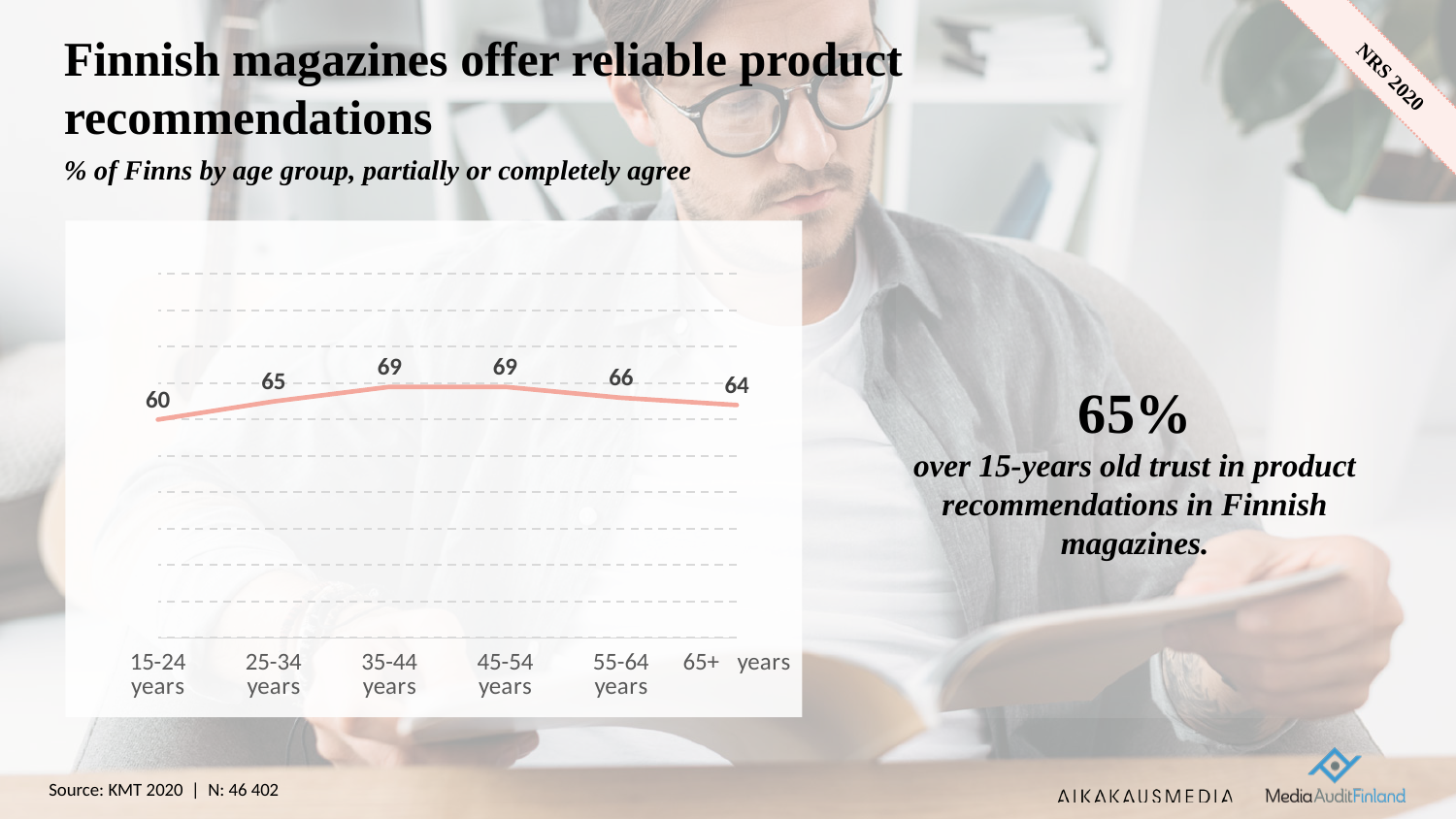
What is the value for the 25-34 years age group? 65 What is the difference between the values for the 55-64 years and 65+ years age groups? 2 What is the difference between the values for the 35-44 years and 15-24 years age groups? 9 What is the highest value shown on the chart? 69 What is the value for the 55-64 years age group? 66 How many age groups are plotted on the chart? 6 Which age group has the lowest value? 15-24 years What is the value for the 15-24 years age group? 60 What kind of chart is shown on the slide? Line chart What is the value for the 65+ years age group? 64 Which is larger, the value for 25-34 years or the value for 55-64 years? 55-64 years Do the values rise or fall from the 45-54 years group to the 65+ years group? Fall